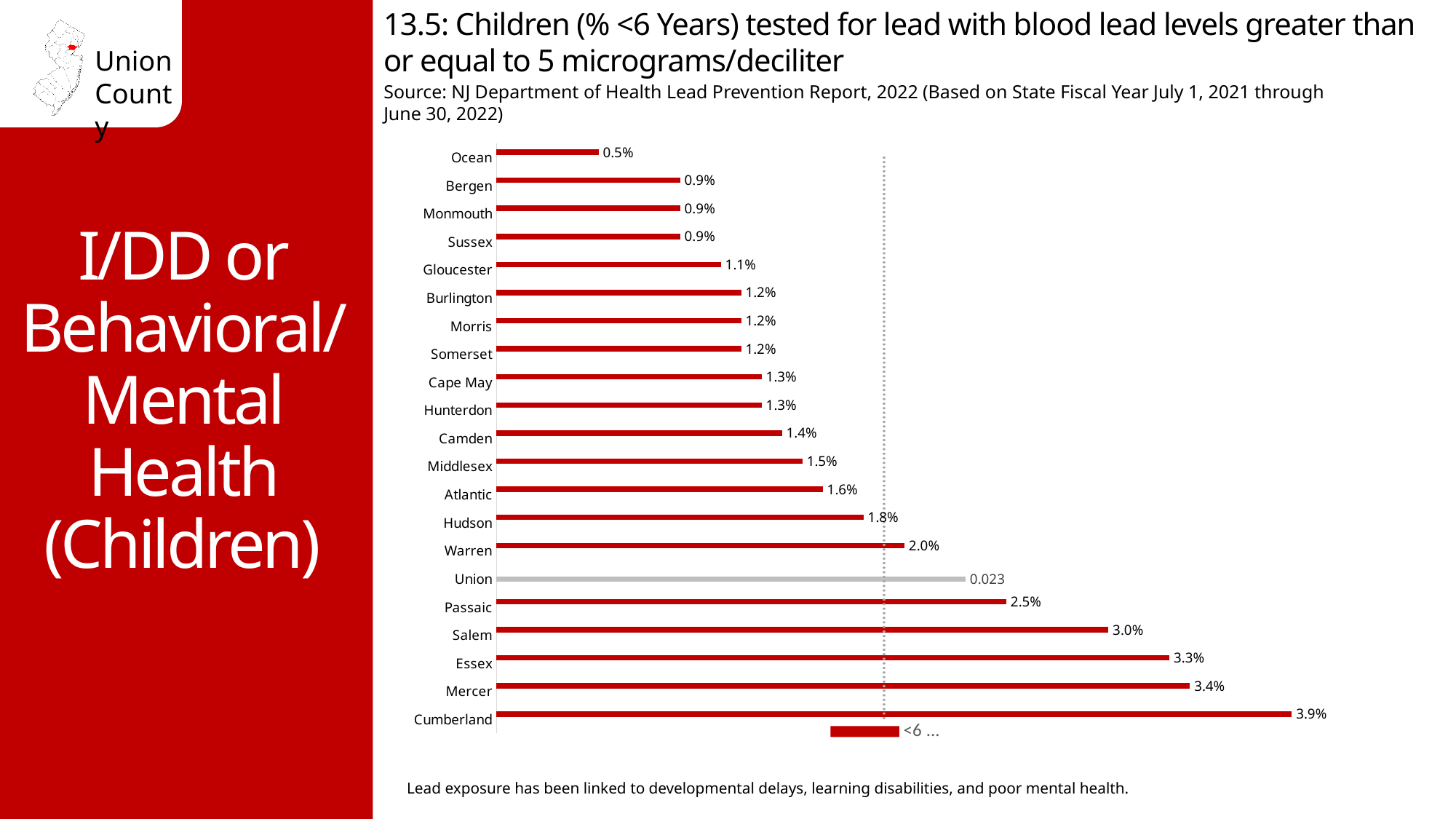
What is the value for Hudson? 1.8% Which county's bar is drawn in gray rather than red? Union Which county has the lowest value? Ocean Which is larger, the value for Salem or the value for Passaic? Salem What value is printed next to the Union bar? 0.023 What is the value for Cumberland? 3.9% What kind of chart is shown on the slide? bar chart What is the difference between the values for Passaic and Warren? 0.5% Which county has the highest value? Cumberland What is the difference between the values for Cumberland and Ocean? 3.4% Which is larger, the value for Atlantic or the value for Camden? Atlantic How many counties are shown in the chart? 21